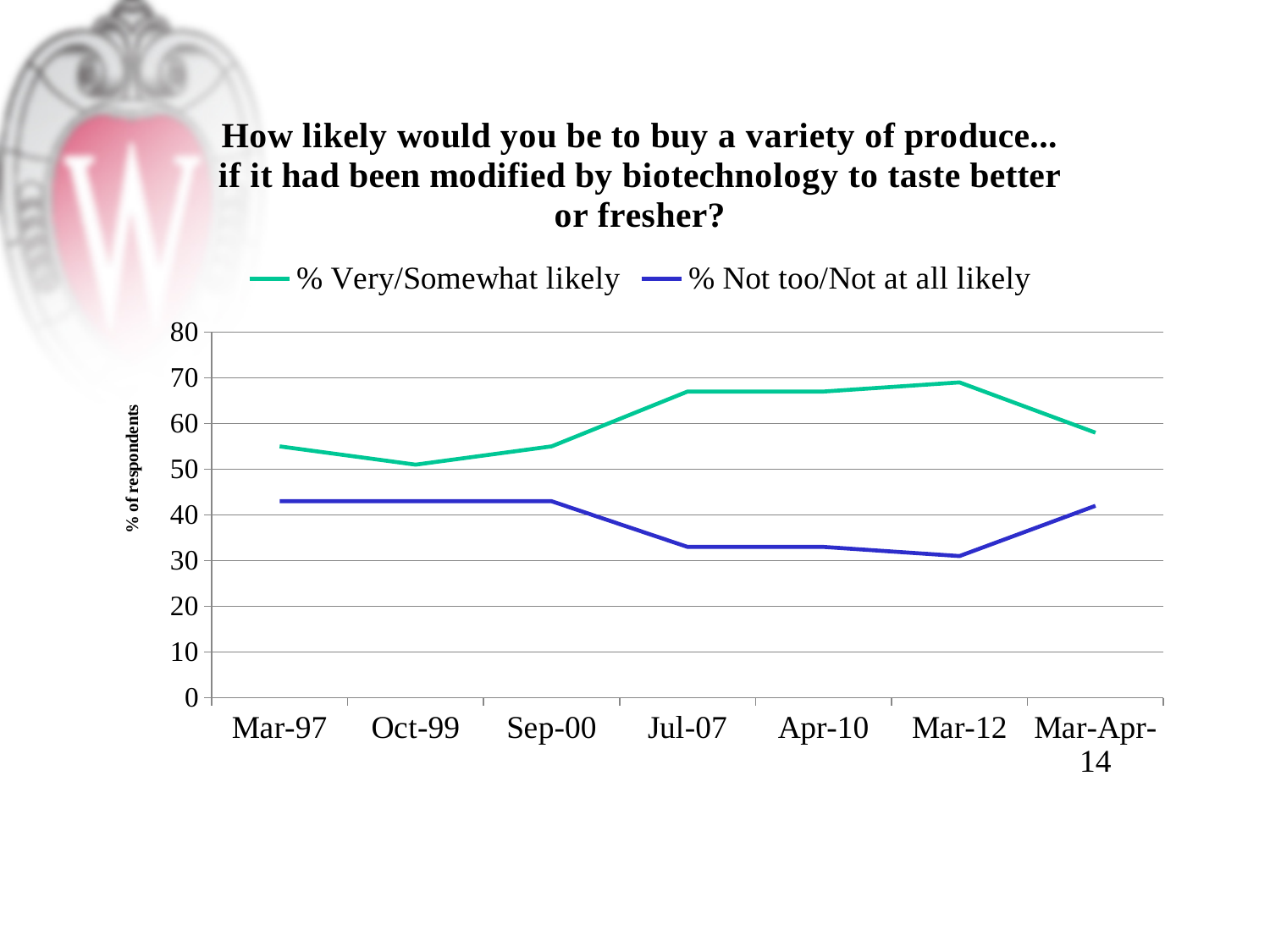
How many series does the legend list? 2 Which series has the larger value at Apr-10, % Very/Somewhat likely or % Not too/Not at all likely? % Very/Somewhat likely Is the value for % Not too/Not at all likely at Jul-07 greater or less than 40? less Which is larger for % Very/Somewhat likely, the value at Mar-97 or the value at Jul-07? Jul-07 At which time point is the % Very/Somewhat likely series lowest? Oct-99 Is the value for % Very/Somewhat likely at Jul-07 greater or less than 60? greater At which time point is the % Very/Somewhat likely series highest? Mar-12 How many time points are shown on the x axis? 7 What kind of chart is shown on the slide? line chart Is the value for % Not too/Not at all likely at Mar-97 greater or less than 40? greater Does the % Not too/Not at all likely series rise or fall from Mar-12 to Mar-Apr-14? rise What is the label on the vertical axis? % of respondents